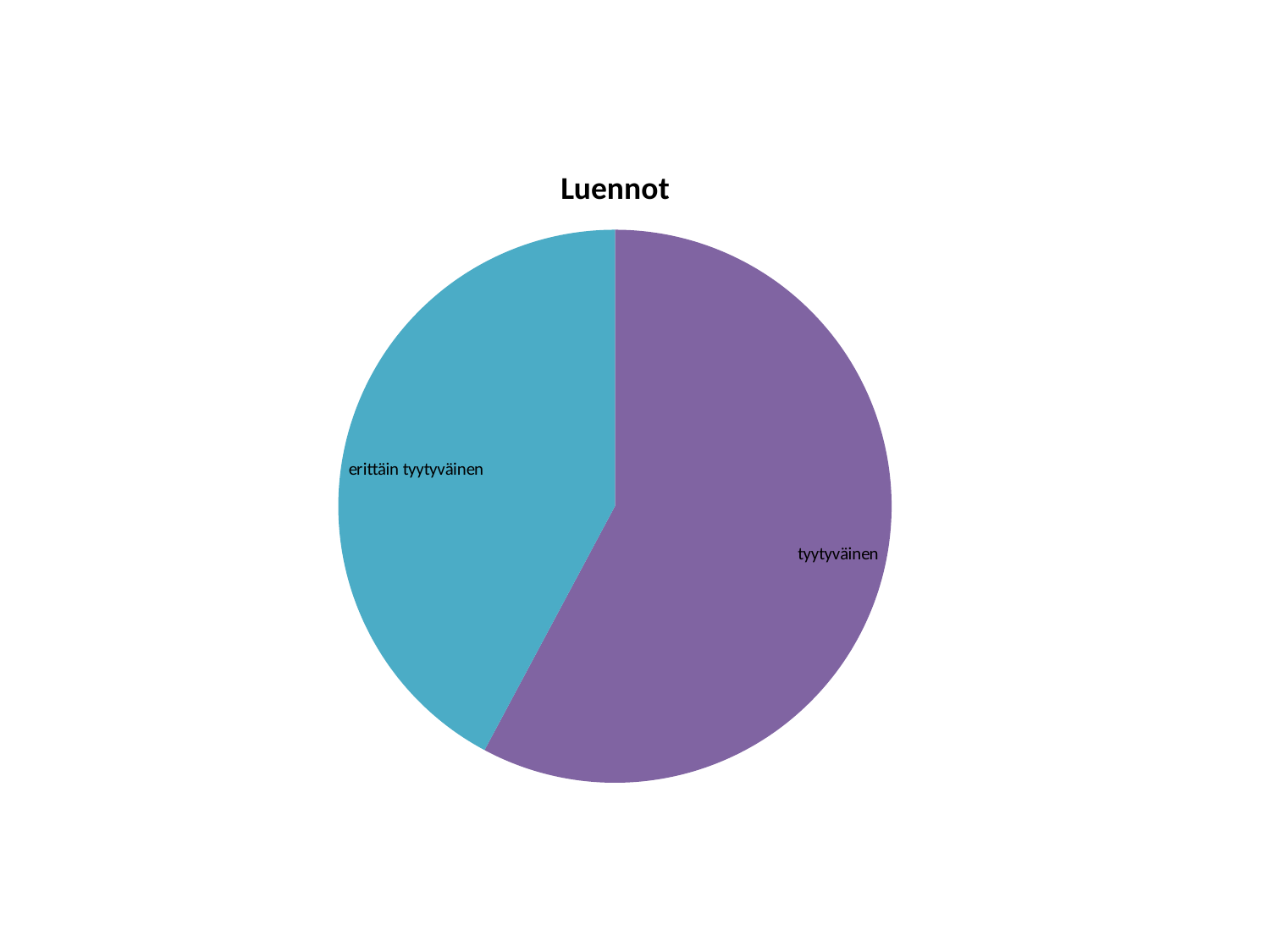
What colour is the "tyytyväinen" slice? purple Is the share of the "tyytyväinen" slice greater or less than half of the pie? greater Which slice of the pie chart is the smallest? erittäin tyytyväinen Is the share of the "erittäin tyytyväinen" slice greater or less than half of the pie? less What is the title of the chart? Luennot Which slice is larger, "tyytyväinen" or "erittäin tyytyväinen"? tyytyväinen What kind of chart is shown on the slide? pie chart How many slices does the pie chart have? 2 Which slice of the pie chart is the largest? tyytyväinen